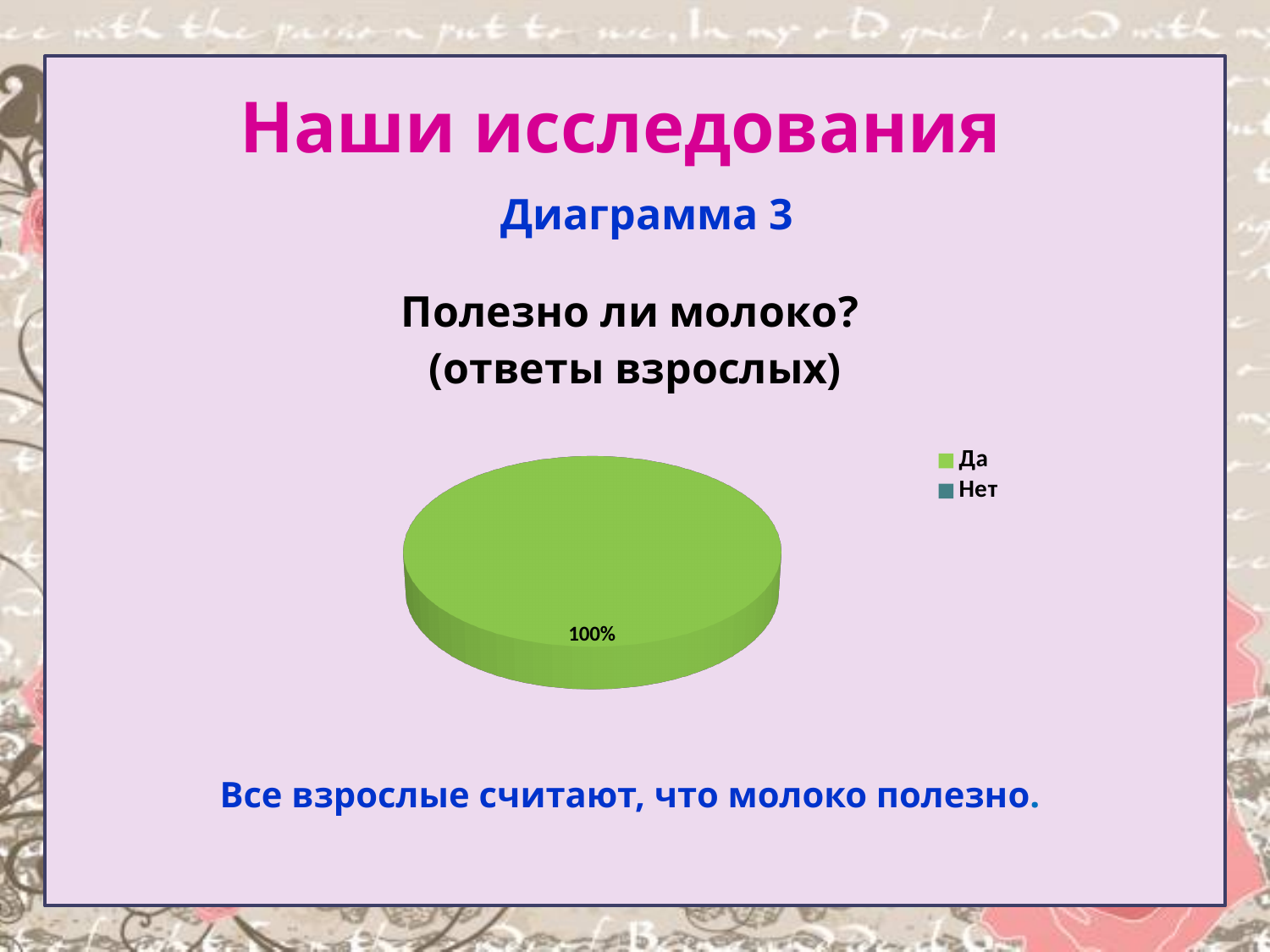
What share of the pie does "Да" take? 100% Which is larger, the share for "Да" or the share for "Нет"? Да How many entries does the legend list? 2 What value is printed on the pie chart? 100% What kind of chart is shown on the slide? pie chart Is the share for "Да" greater or less than 50%? greater What colour is the "Да" slice in the pie chart? green Which category has the largest share of the pie? Да What is the title of the chart? Полезно ли молоко? (ответы взрослых)